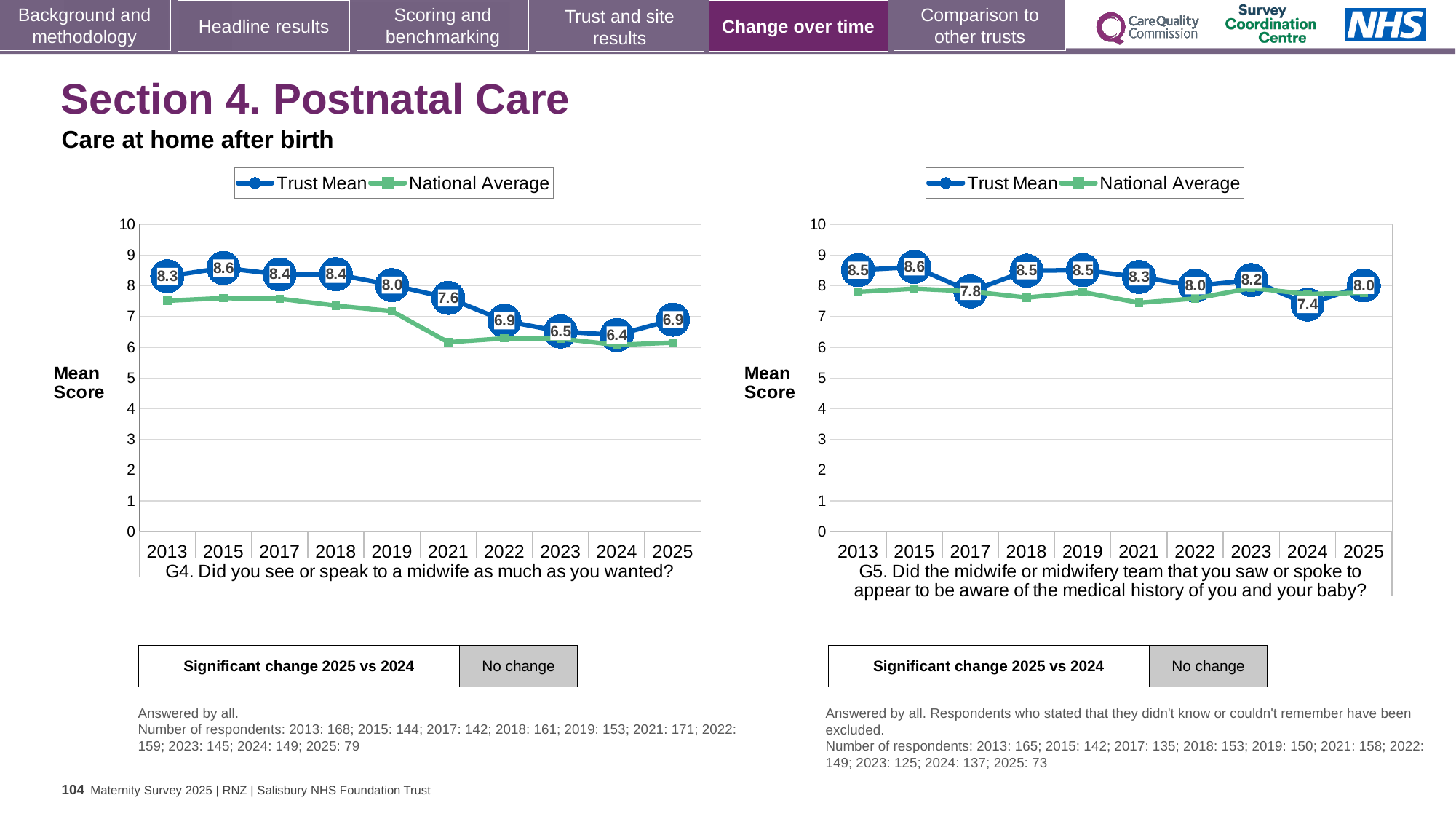
How many series does the legend of the G5 chart on the right list? 2 How many years are plotted on the x axis of the G4 chart on the left? 10 In the G5 chart on the right, which year has the lowest Trust Mean score? 2024 In the G4 chart on the left, which year has the highest Trust Mean score? 2015 In the G5 chart on the right, what is the difference between the Trust Mean scores for 2023 and 2024? 0.8 In the G5 chart on the right, is the Trust Mean score higher in 2017 or in 2021? 2021 In the G4 chart on the left, what is the Trust Mean score for 2019? 8.0 What type of chart is the G4 chart on the left? Line chart In the G5 chart on the right, what is the Trust Mean score for 2024? 7.4 In the G4 chart on the left, is the National Average value for 2021 greater or less than 7? less In the G4 chart on the left, what is the difference between the Trust Mean scores for 2013 and 2025? 1.4 In the G4 chart on the left, which year has the lowest Trust Mean score? 2024